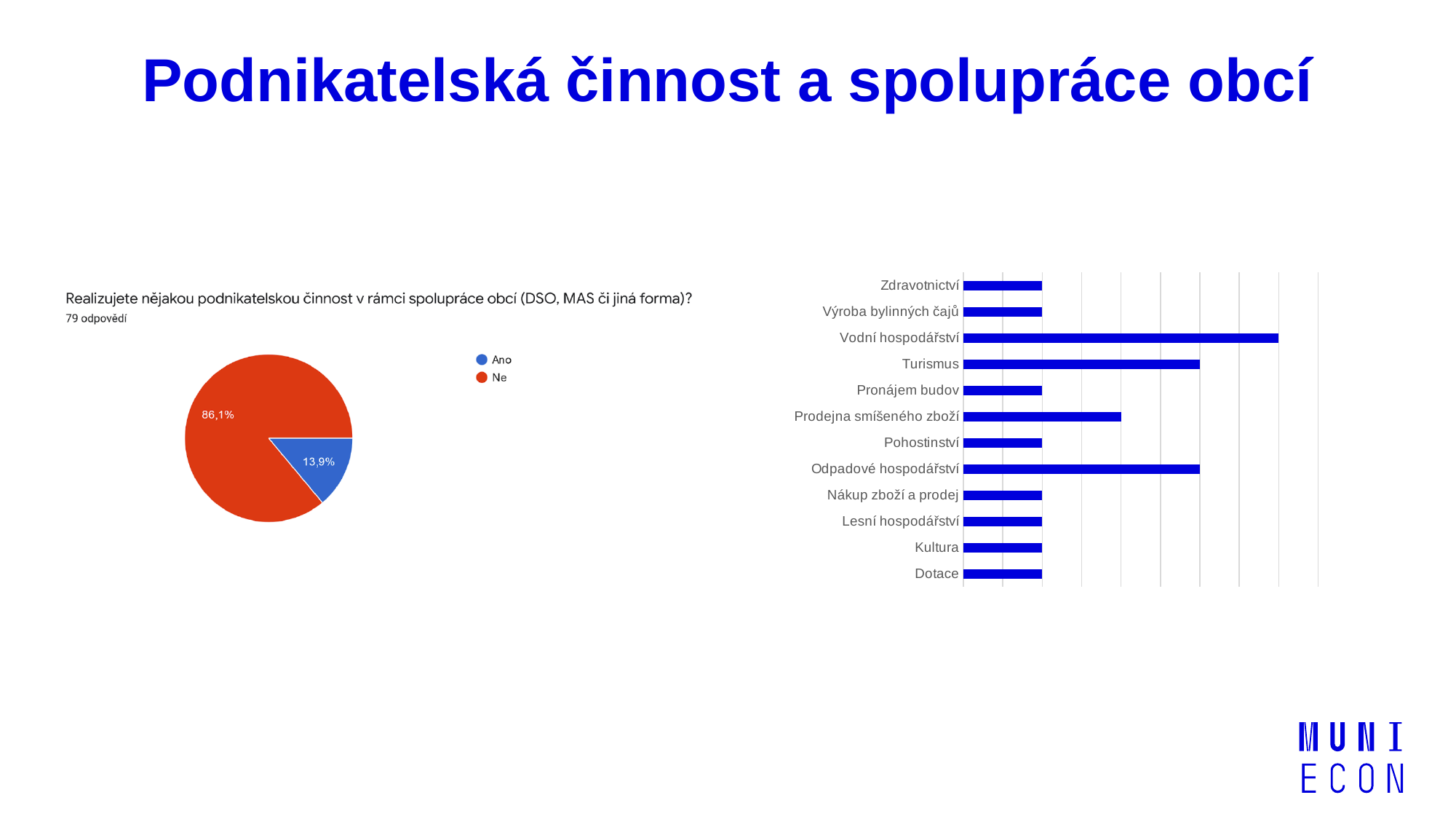
In the pie chart on the left, what percentage of respondents answered "Ano"? 13,9% In the bar chart on the right, which bar is longer, Turismus or Prodejna smíšeného zboží? Turismus How many responses does the pie chart on the left report? 79 odpovědí How many entries does the legend of the pie chart on the left list? 2 In the pie chart on the left, which answer has the larger share, "Ano" or "Ne"? Ne What kind of chart is the chart on the left of the slide? Pie chart In the bar chart on the right, which category has the longest bar? Vodní hospodářství How many categories does the bar chart on the right show? 12 What kind of chart is the chart on the right of the slide? Bar chart In the pie chart on the left, what percentage of respondents answered "Ne"? 86,1% In the bar chart on the right, which bar is longer, Odpadové hospodářství or Pohostinství? Odpadové hospodářství In the pie chart on the left, what is the difference in percentage points between the "Ne" and "Ano" shares? 72,2